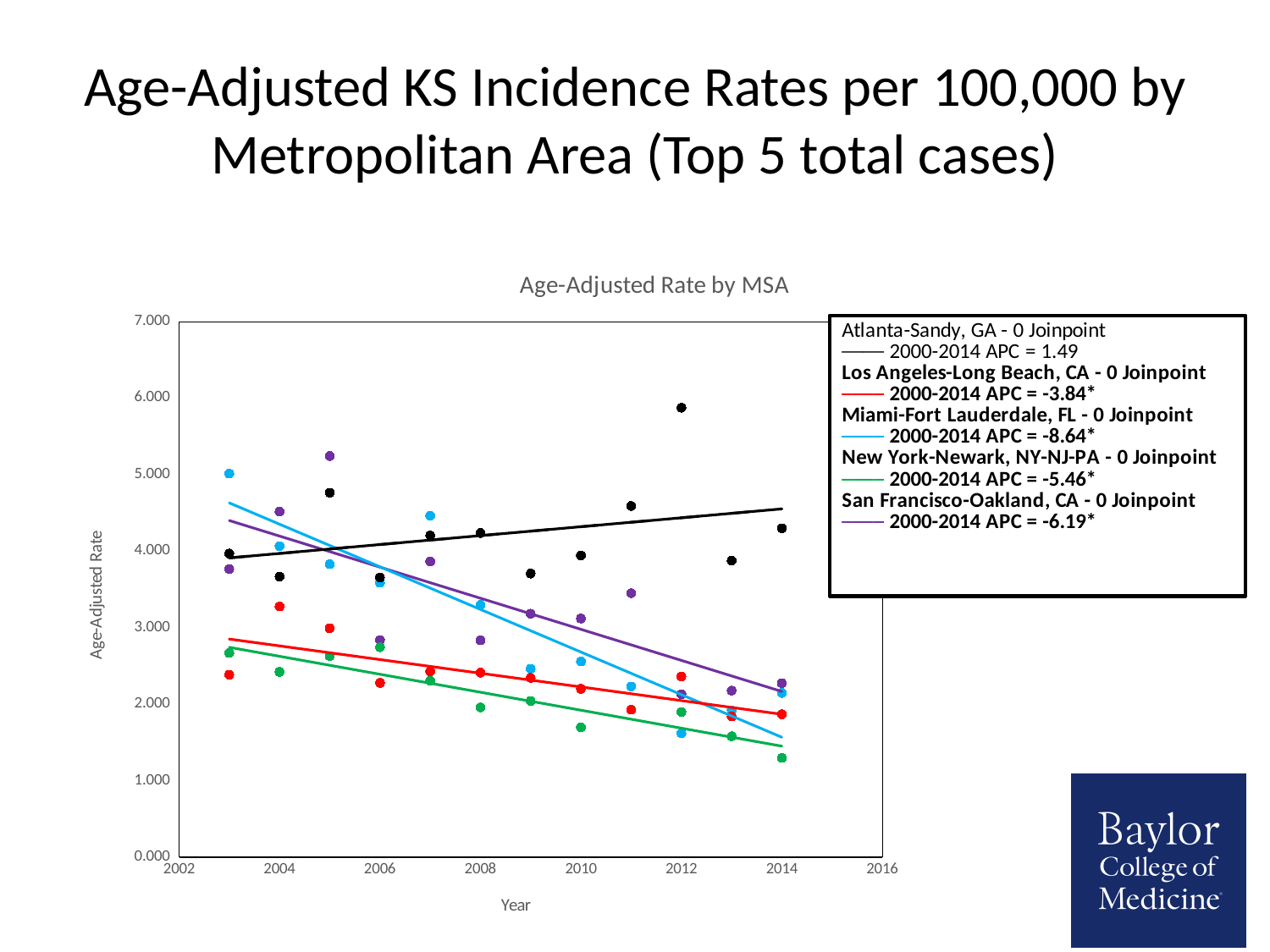
What is the 2000-2014 APC shown in the legend for Miami-Fort Lauderdale, FL? -8.64* In 2012, which is larger: the Atlanta-Sandy, GA value or the New York-Newark, NY-NJ-PA value? Atlanta-Sandy, GA Is the Atlanta-Sandy, GA value for 2012 greater or less than 5.000? greater Which metropolitan area has the most negative APC in the legend? Miami-Fort Lauderdale, FL Does the blue trend line for Miami-Fort Lauderdale, FL rise or fall from 2003 to 2014? fall Does the black trend line for Atlanta-Sandy, GA rise or fall from 2003 to 2014? rise What kind of chart is shown on the slide? scatter chart with trend lines How many series does the legend list? 5 What is the title of the chart? Age-Adjusted Rate by MSA What is the label of the y axis? Age-Adjusted Rate Which metropolitan area has the only positive APC in the legend? Atlanta-Sandy, GA What is the 2000-2014 APC shown in the legend for Atlanta-Sandy, GA? 1.49